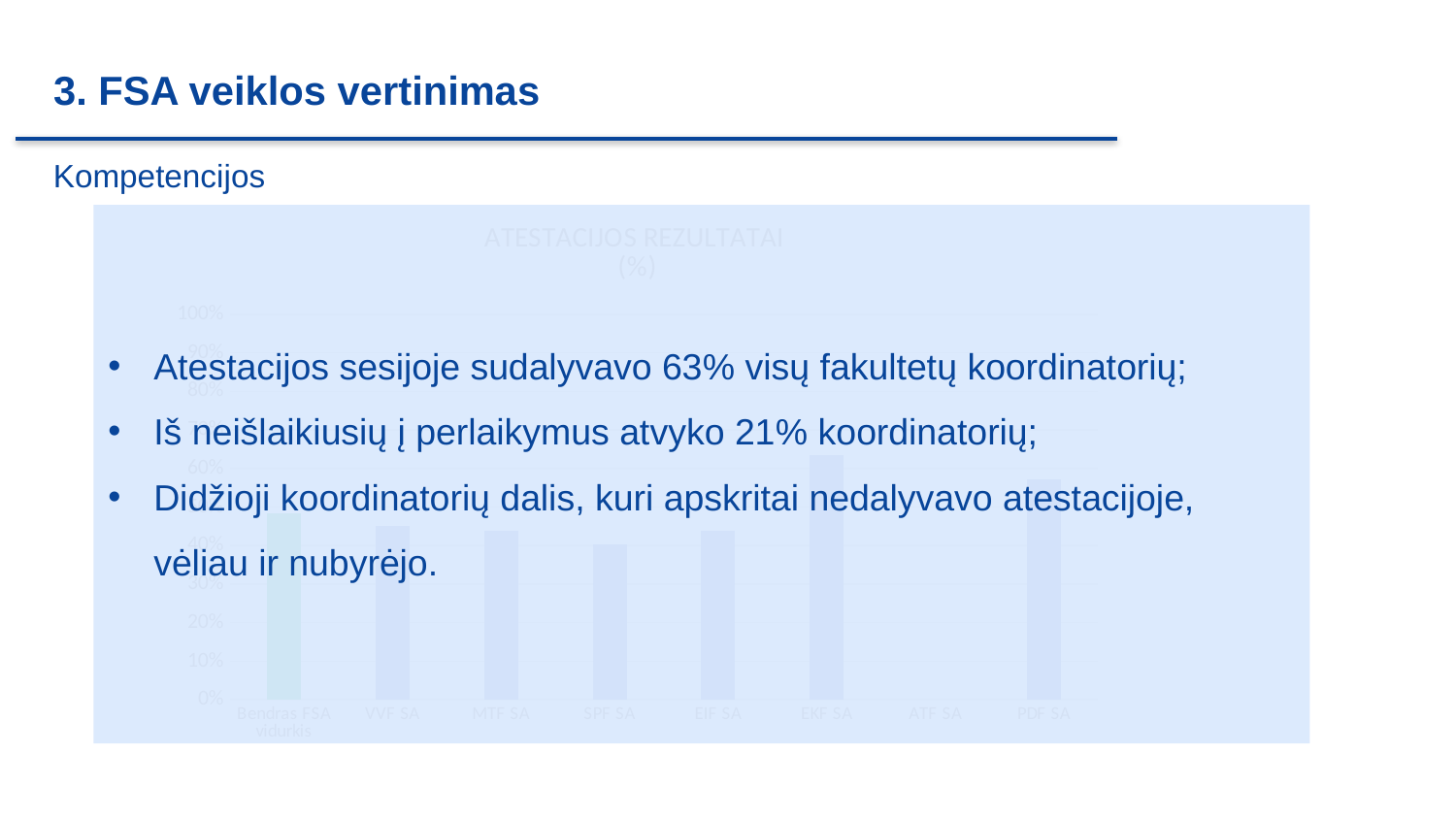
What kind of chart is shown on the slide? bar chart Which category has the highest bar in the chart? EKF SA Is the value for EKF SA greater or less than 50%? greater Is the value for PDF SA greater or less than 50%? greater Is the value for SPF SA greater or less than 50%? less What is the title of the chart? ATESTACIJOS REZULTATAI (%) How many categories are shown on the x axis of the chart? 8 Which is larger, the value for PDF SA or the value for MTF SA? PDF SA Which is larger, the value for EKF SA or the value for SPF SA? EKF SA What is the highest tick value shown on the y axis of the chart? 100%